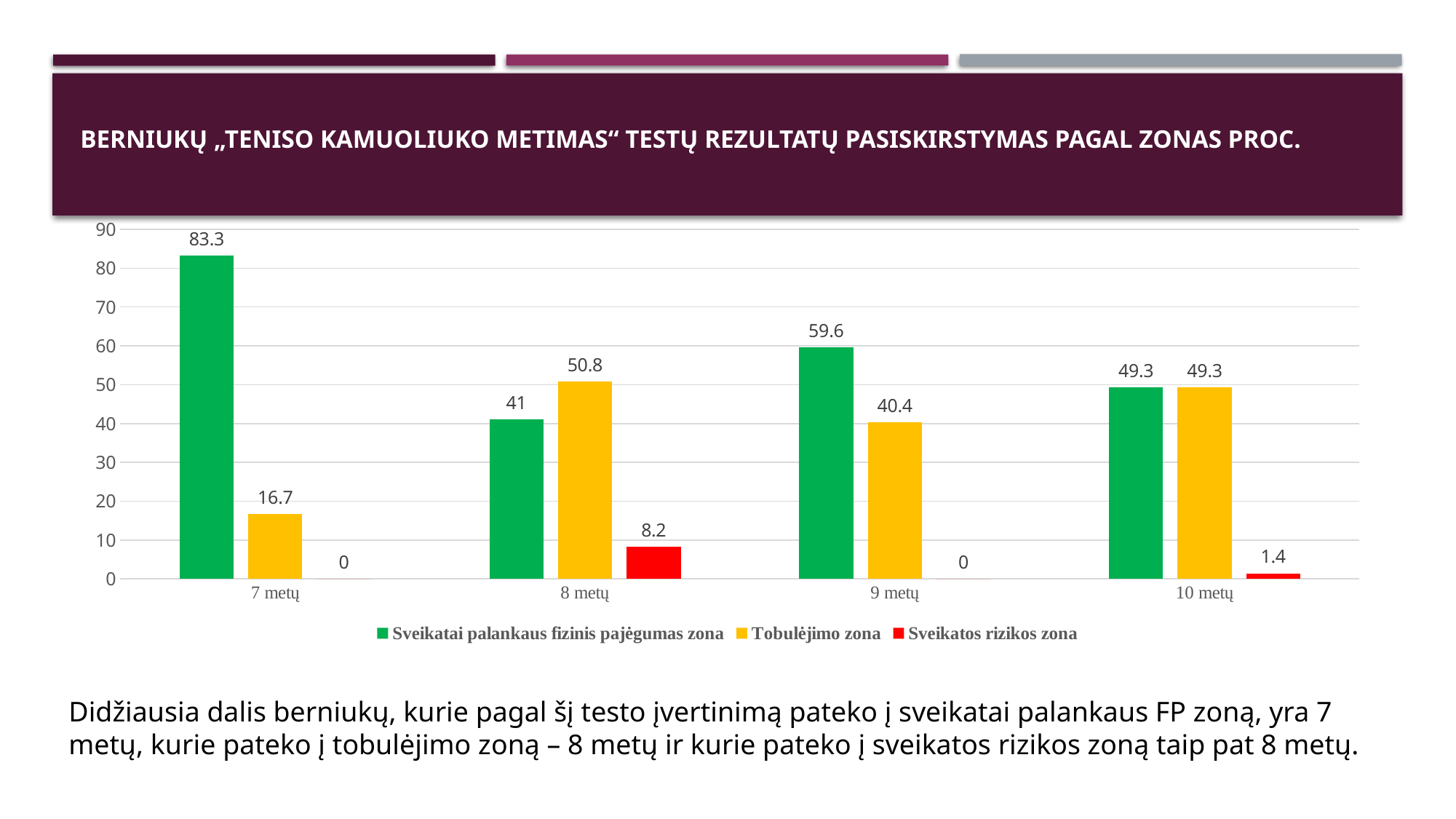
Which is larger for 8 metų: 'Sveikatai palankaus fizinis pajėgumas zona' or 'Tobulėjimo zona'? Tobulėjimo zona What is the value for 'Tobulėjimo zona' for 8 metų? 50.8 What is the difference between the 'Sveikatai palankaus fizinis pajėgumas zona' values for 7 metų and 8 metų? 42.3 What is the value for 'Tobulėjimo zona' for 9 metų? 40.4 What kind of chart is shown on the slide? Bar chart What is the value for 'Sveikatos rizikos zona' for 10 metų? 1.4 Which age group has the lowest value for 'Tobulėjimo zona'? 7 metų How many series does the legend list? 3 How many age groups are shown on the x axis? 4 Which age group has the highest value for 'Sveikatai palankaus fizinis pajėgumas zona'? 7 metų What colour represents 'Sveikatos rizikos zona' in the chart? Red What is the value for 'Sveikatai palankaus fizinis pajėgumas zona' for 7 metų? 83.3